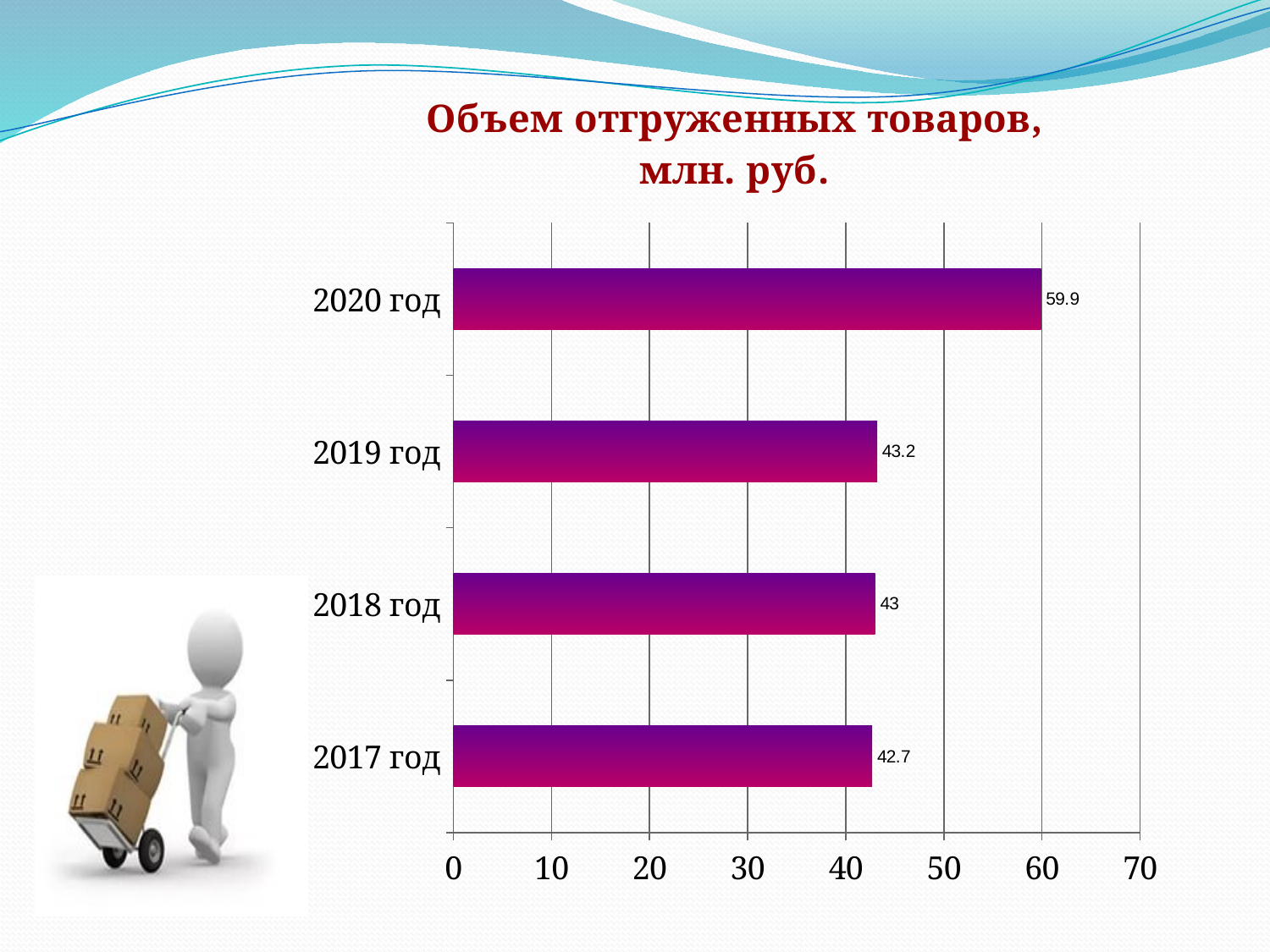
What is the value for 2020 год? 59.9 What is the value for 2019 год? 43.2 Is the value for 2020 год greater or less than 50? greater What is the value for 2017 год? 42.7 What is the difference between the values for 2018 год and 2017 год? 0.3 Which year has the lowest value? 2017 год What kind of chart is shown on the slide? bar chart What is the title of the chart? Объем отгруженных товаров, млн. руб. Which is larger, the value for 2020 год or the value for 2018 год? 2020 год How many years are shown in the chart? 4 Which year has the highest value? 2020 год What is the difference between the values for 2020 год and 2019 год? 16.7